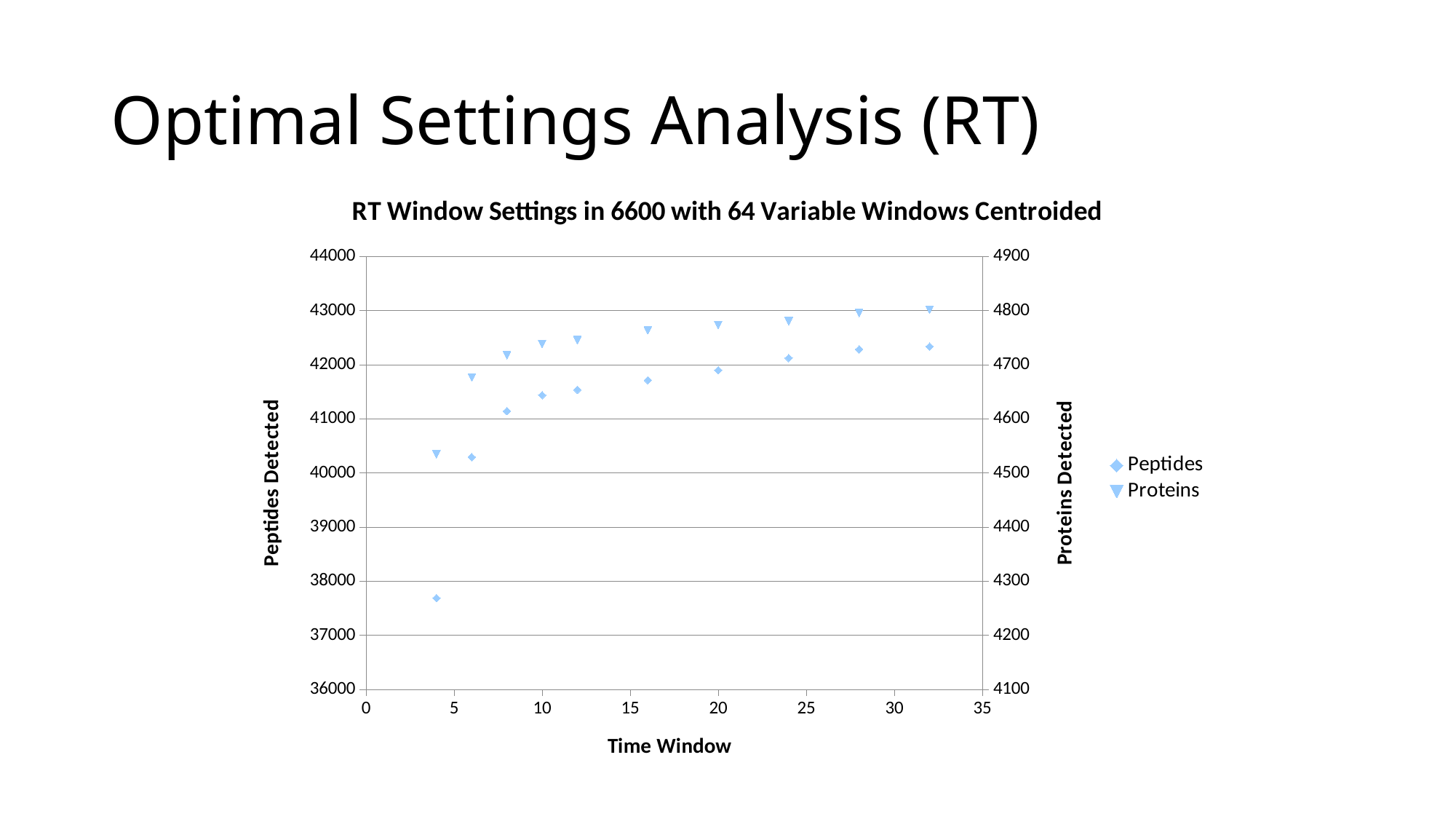
What is the title of the chart? RT Window Settings in 6600 with 64 Variable Windows Centroided Do the Peptides Detected values rise or fall as the Time Window increases? rise How many series does the legend list? 2 Is the Peptides Detected value at Time Window 32 greater or less than 42000? greater How many data points are plotted for the Peptides series? 10 Is the Peptides Detected value at Time Window 4 greater or less than 38000? less Is the Peptides Detected value at Time Window 6 greater or less than 40000? greater At which Time Window is the Proteins Detected value lowest? 4 What kind of chart is shown on the slide? scatter chart Which Time Window has the larger Peptides Detected value, 4 or 6? 6 At which Time Window is the Peptides Detected value lowest? 4